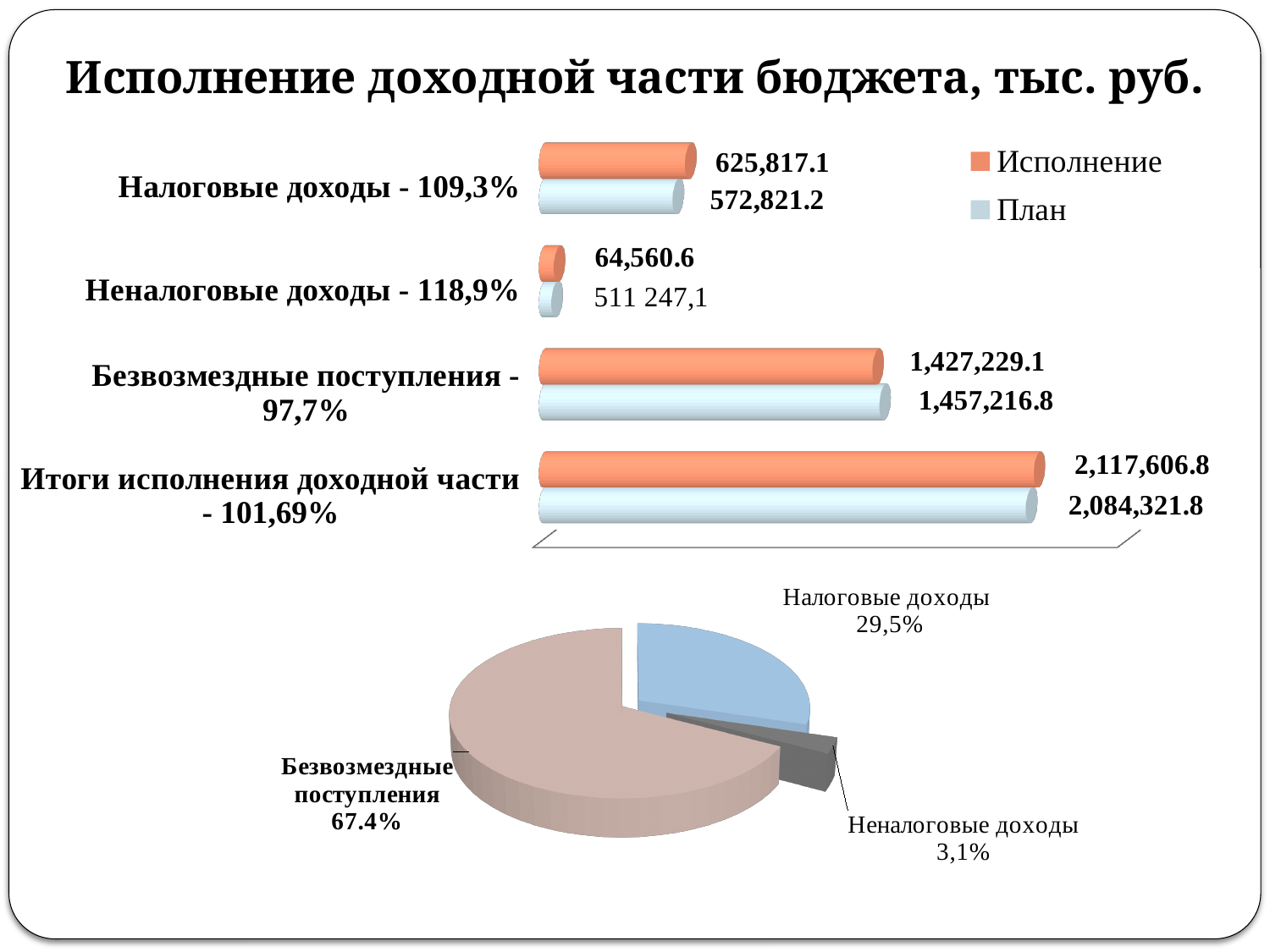
On the pie chart, what share does Безвозмездные поступления have? 67.4% How many slices does the pie chart have? 3 On the bar chart, what is the Исполнение value for Итоги исполнения доходной части? 2,117,606.8 On the bar chart, for Безвозмездные поступления, which is larger: Исполнение or План? План On the bar chart, what is the Исполнение value for Налоговые доходы? 625,817.1 On the bar chart, what is the difference between the Исполнение and План values for Налоговые доходы? 52,995.9 On the bar chart, what is the Исполнение value for Неналоговые доходы? 64,560.6 On the pie chart, which slice is the smallest? Неналоговые доходы On the bar chart, what is the План value for Безвозмездные поступления? 1,457,216.8 What type of chart is the top chart on the slide? Bar chart How many series does the legend of the bar chart list? 2 On the bar chart, which category has the lowest Исполнение value? Неналоговые доходы